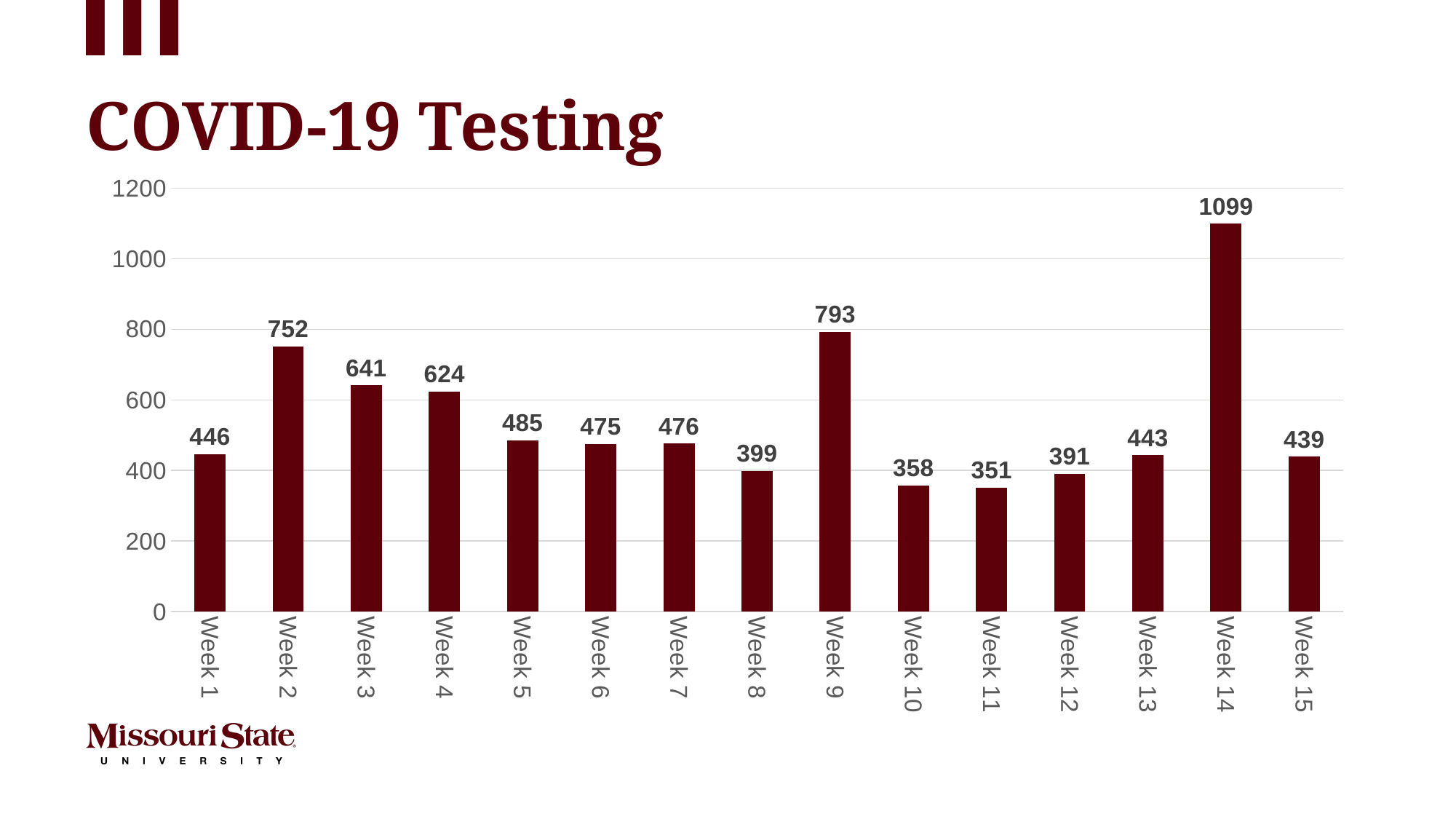
What is the value for Week 9? 793 Which week has the highest value? Week 14 Which is larger, the value for Week 4 or the value for Week 5? Week 4 What is the value for Week 15? 439 What is the difference between the values for Week 14 and Week 9? 306 What is the title of the slide? COVID-19 Testing Which week has the lowest value? Week 11 What is the difference between the values for Week 2 and Week 1? 306 What kind of chart is shown on the slide? Bar chart How many weeks are shown on the chart? 15 Is the value for Week 14 greater or less than 1000? greater What is the value for Week 3? 641